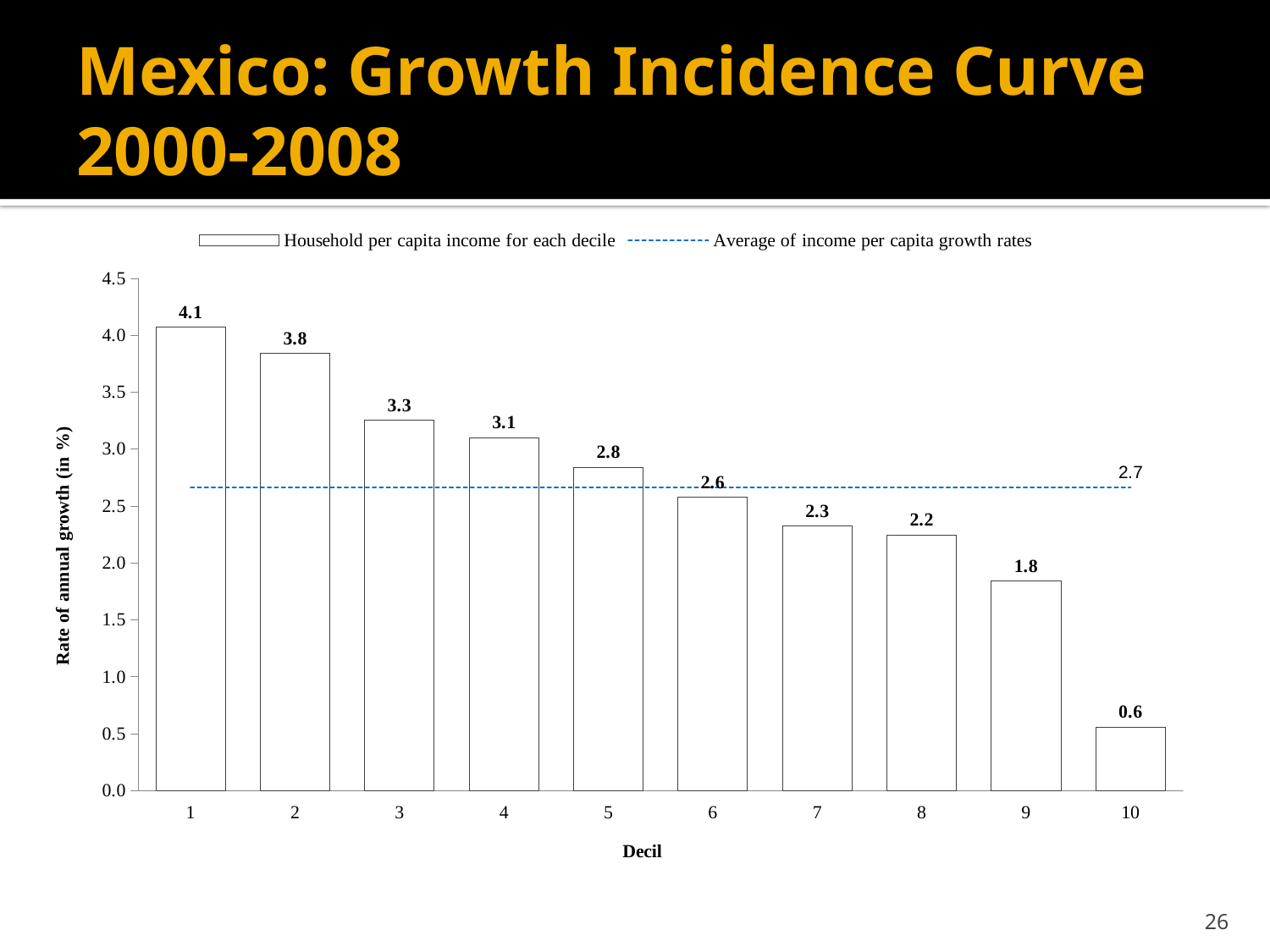
What is the rate of annual growth for decile 5? 2.8 Which has a higher rate of annual growth, decile 3 or decile 7? Decile 3 What is the rate of annual growth for decile 1? 4.1 How many series does the legend list? 2 How many deciles are shown on the x axis? 10 What is the difference between the growth rates of decile 1 and decile 10? 3.5 Which decile has the lowest rate of annual growth? 10 What is the rate of annual growth for decile 10? 0.6 What value is shown for the average of income per capita growth rates line? 2.7 Is the value for decile 9 greater or less than 2.0? less Do the growth rates rise or fall as the decile number increases? Fall Which decile has the highest rate of annual growth? 1